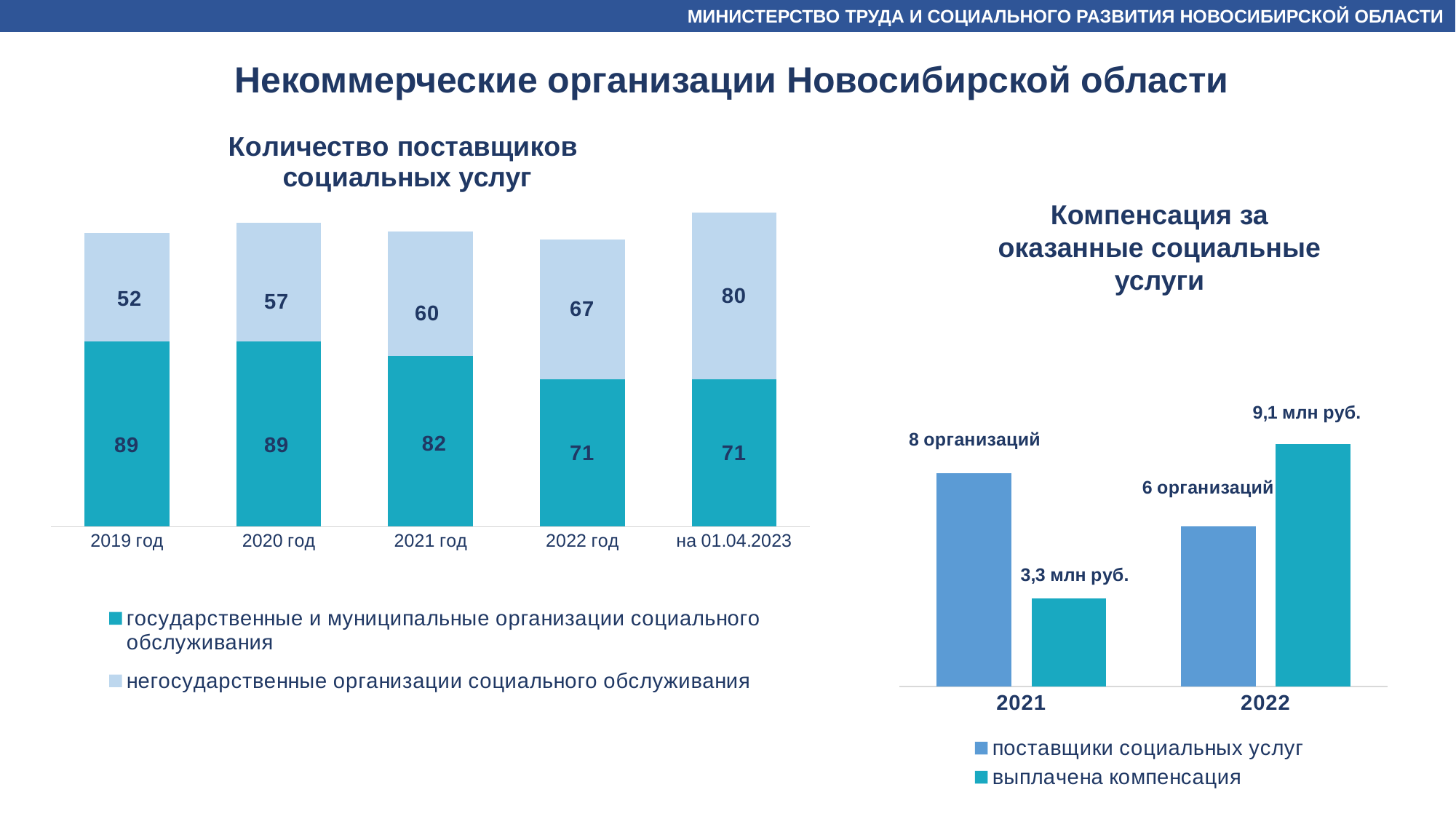
In the chart 'Количество поставщиков социальных услуг', what is the value for государственные и муниципальные организации социального обслуживания in 2019 год? 89 In the chart 'Количество поставщиков социальных услуг', how many series does the legend list? 2 In the chart 'Количество поставщиков социальных услуг', which category has the highest value for негосударственные организации социального обслуживания? на 01.04.2023 In the chart 'Количество поставщиков социальных услуг', how many categories are shown on the x axis? 5 In the chart 'Компенсация за оказанные социальные услуги', which year has the larger value for выплачена компенсация, 2021 or 2022? 2022 In the chart 'Компенсация за оказанные социальные услуги', what is the value for выплачена компенсация in 2022? 9,1 млн руб. In the chart 'Количество поставщиков социальных услуг', does the value for негосударственные организации социального обслуживания rise or fall from 2019 год to 01.04.2023? rise In the chart 'Количество поставщиков социальных услуг', what is the value for негосударственные организации социального обслуживания on 01.04.2023? 80 What kind of chart is 'Компенсация за оказанные социальные услуги'? bar chart In the chart 'Количество поставщиков социальных услуг', what is the total of the stacked bar for 2021 год? 142 In the chart 'Количество поставщиков социальных услуг', what is the difference between the государственные и муниципальные value and the негосударственные value in 2022 год? 4 In the chart 'Компенсация за оказанные социальные услуги', what is the value for поставщики социальных услуг in 2021? 8 организаций